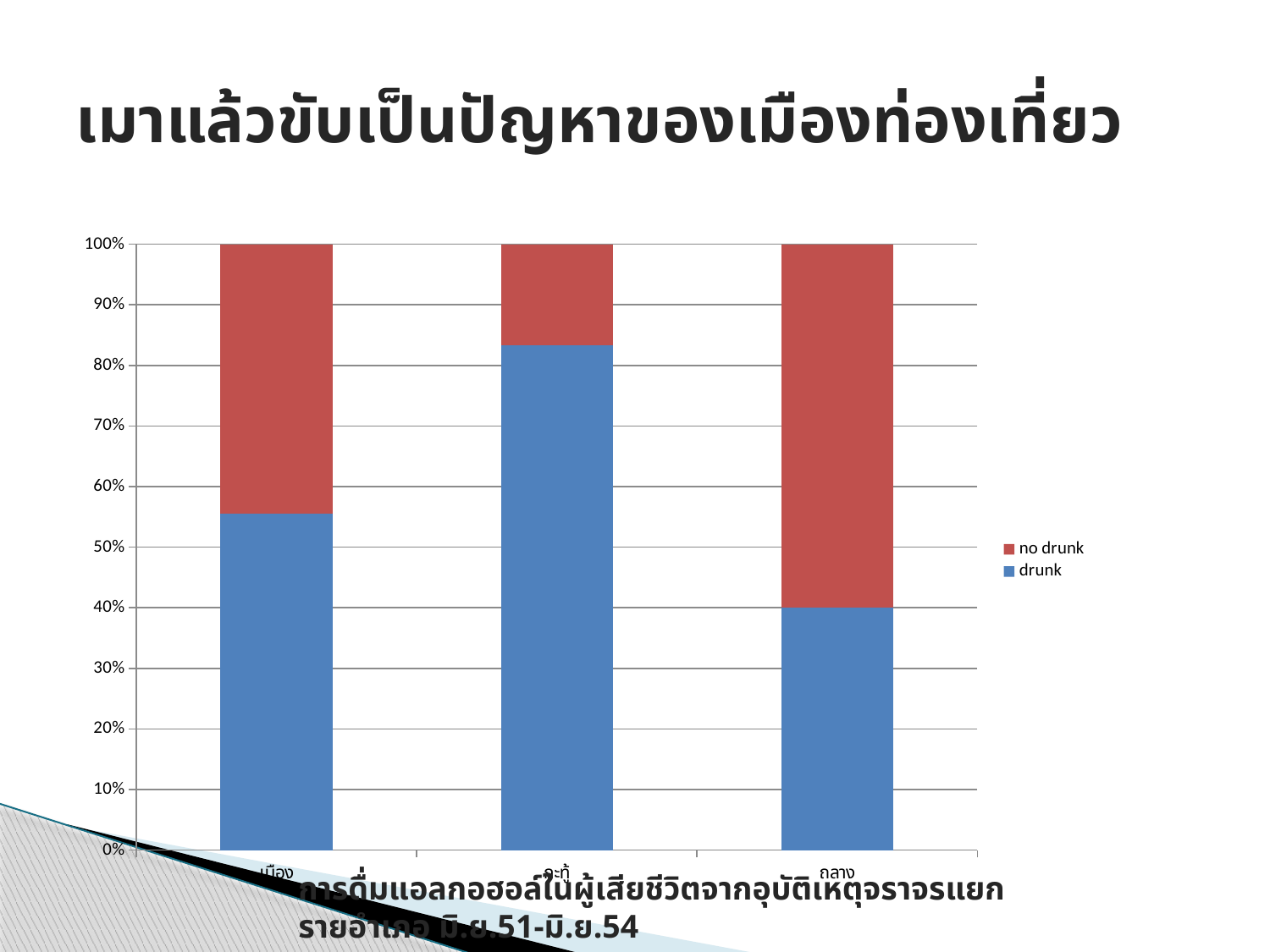
Is the drunk share for กะทู้ greater or less than 80%? greater Which category has the highest share for the no drunk series? ถลาง What kind of chart is shown on the slide? bar chart Is the drunk share for เมือง greater or less than 50%? greater What is the total of the stacked bar for เมือง? 100% Which category has a larger drunk share, เมือง or ถลาง? เมือง Which category has the highest share for the drunk series? กะทู้ What colour represents the drunk series? blue How many categories are shown on the x axis? 3 Is the no drunk share for กะทู้ greater or less than 20%? less Which category has the lowest share for the drunk series? ถลาง How many series does the legend list? 2